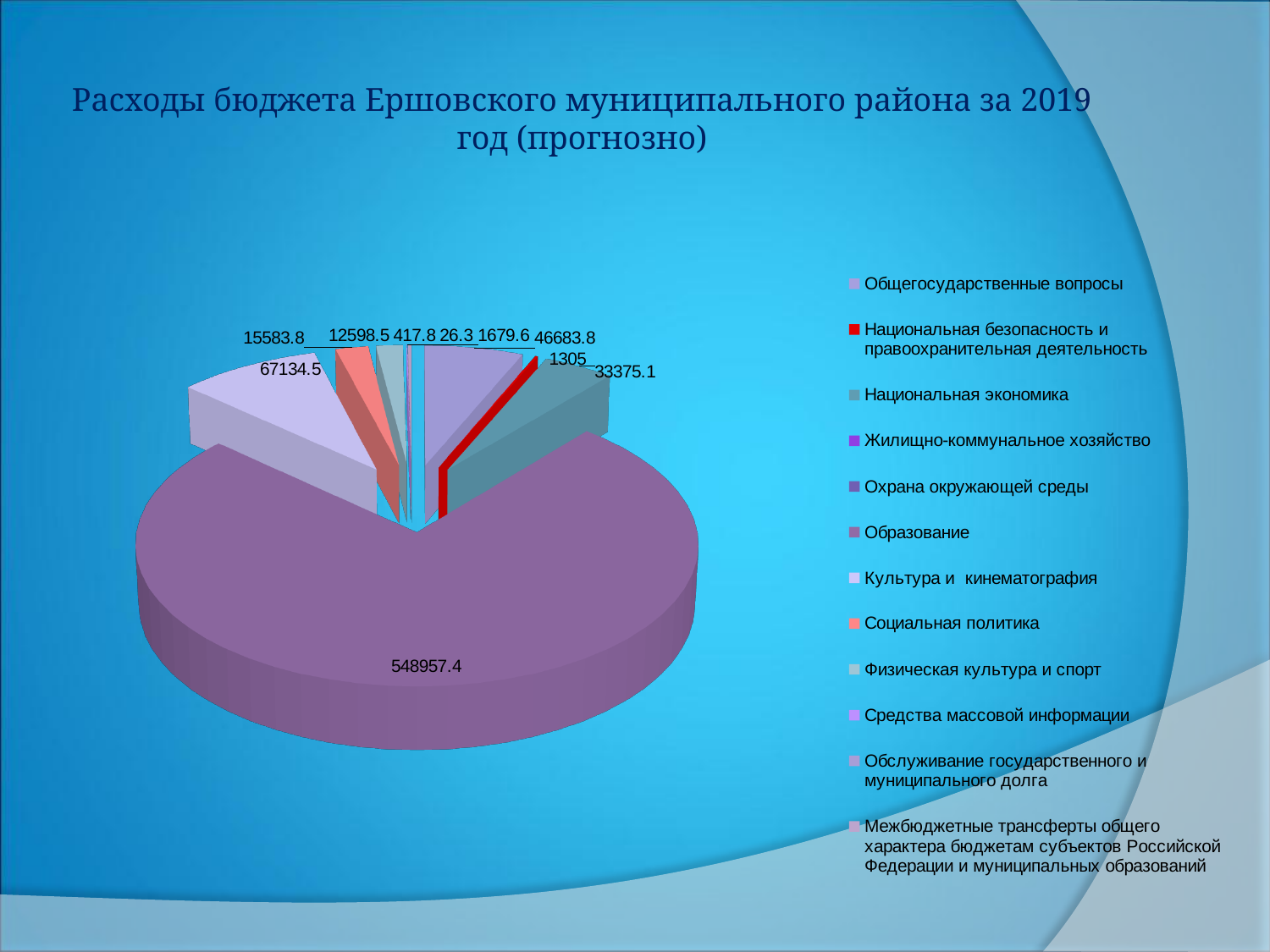
Which category has the largest slice of the pie chart? Образование What is the value shown for Образование? 548957.4 What is the value shown for Социальная политика? 15583.8 What kind of chart is shown on the slide? pie chart What is the difference between the values for Культура и кинематография and Общегосударственные вопросы? 20450.7 What is the value shown for Общегосударственные вопросы? 46683.8 What is the value shown for Национальная экономика? 33375.1 Which is larger, the value for Культура и кинематография or the value for Общегосударственные вопросы? Культура и кинематография What is the title of the chart on the slide? Расходы бюджета Ершовского муниципального района за 2019 год (прогнозно) What is the value shown for Культура и кинематография? 67134.5 How many categories does the legend of the pie chart list? 12 What is the value shown for Национальная безопасность и правоохранительная деятельность? 1305